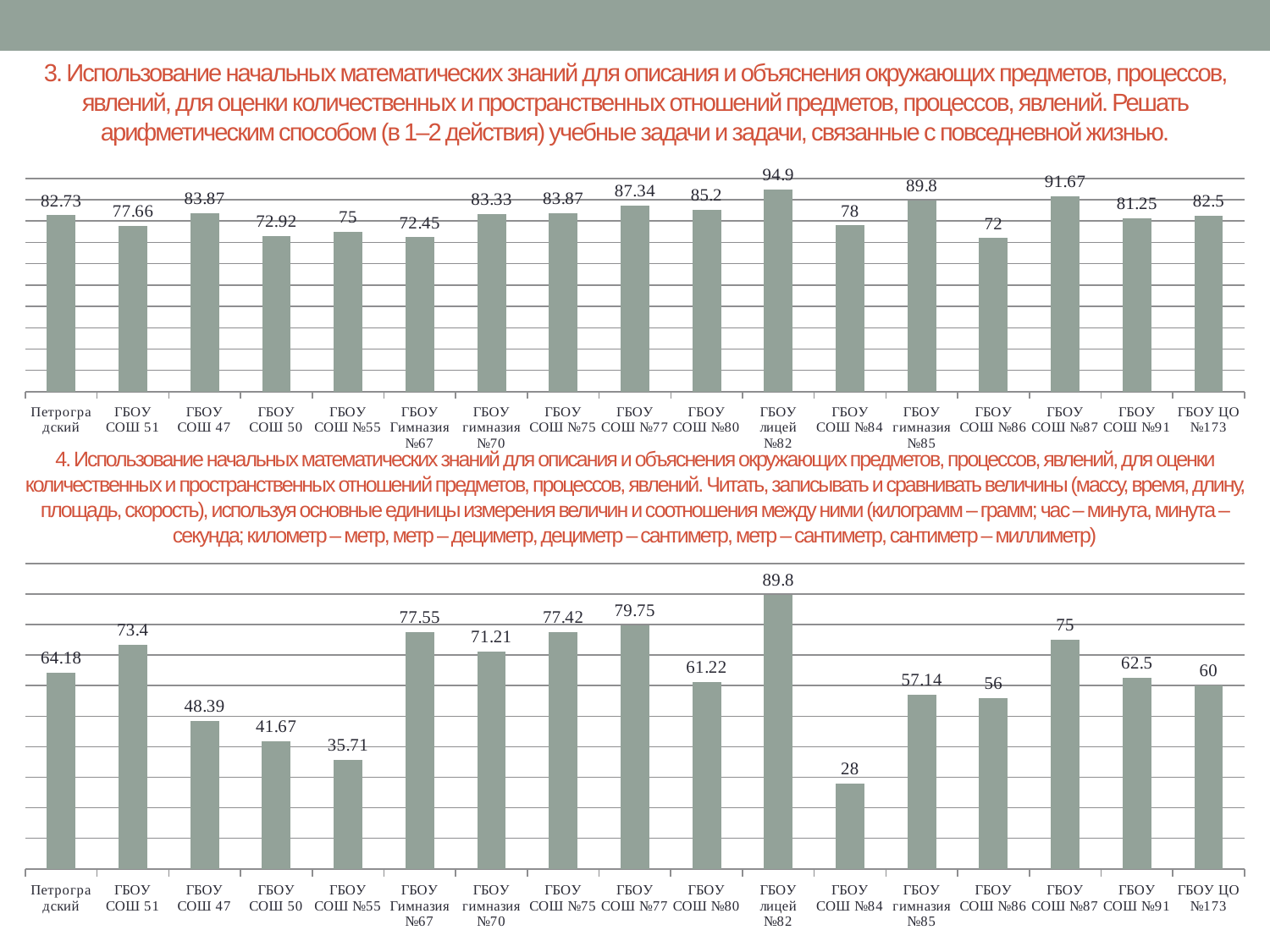
In the top chart, what is the value for ГБОУ лицей №82? 94.9 In the top chart, which school has the lowest value? ГБОУ СОШ №86 In the bottom chart, which school has the lowest value? ГБОУ СОШ №84 In the top chart, which is larger: the value for ГБОУ СОШ 51 or the value for ГБОУ СОШ №84? ГБОУ СОШ №84 What type of chart is the bottom chart? Bar chart In the bottom chart, what is the value for ГБОУ Гимназия №67? 77.55 In the bottom chart, what is the value for ГБОУ СОШ №84? 28 In the bottom chart, which is larger: the value for Петроградский or the value for ГБОУ СОШ №91? Петроградский In the top chart, what is the difference between the values for ГБОУ СОШ №87 and ГБОУ СОШ №91? 10.42 In the bottom chart, what is the difference between the values for ГБОУ СОШ №77 and ГБОУ СОШ №80? 18.53 In the top chart, how many categories are plotted? 17 In the bottom chart, which school has the highest value? ГБОУ лицей №82